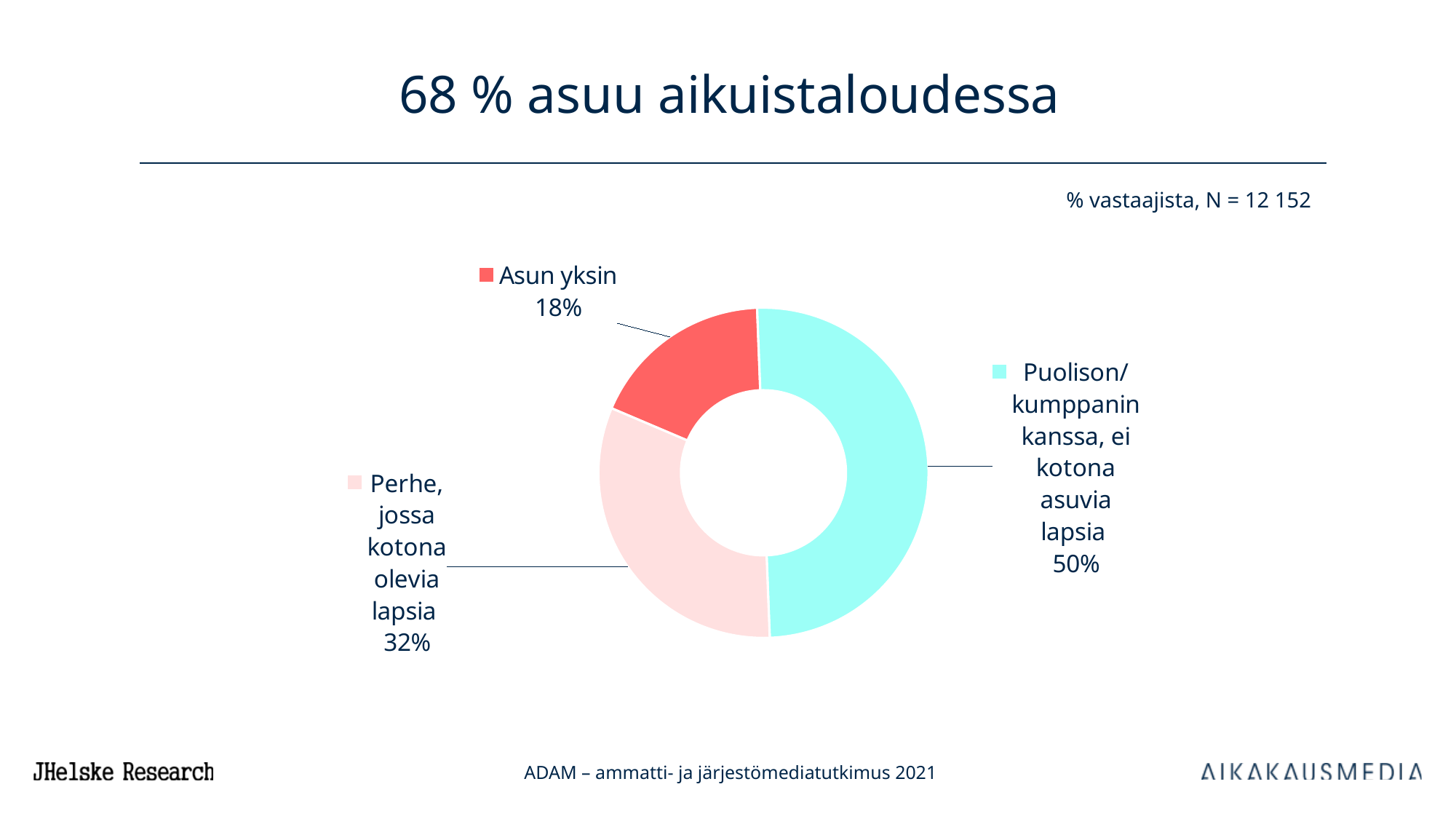
What is the sample size (N) stated on the slide? 12 152 What is the difference in percentage points between "Perhe, jossa kotona olevia lapsia" and "Asun yksin"? 14 What percentage of respondents answered "Puolison/kumppanin kanssa, ei kotona asuvia lapsia"? 50% What is the title of the slide? 68 % asuu aikuistaloudessa What percentage of respondents answered "Perhe, jossa kotona olevia lapsia"? 32% Which category has the smallest share of the chart? Asun yksin What kind of chart is shown on the slide? Pie chart (doughnut) Which category has the largest share of the chart? Puolison/kumppanin kanssa, ei kotona asuvia lapsia Which is larger: the share for "Asun yksin" or the share for "Perhe, jossa kotona olevia lapsia"? Perhe, jossa kotona olevia lapsia What is the difference in percentage points between "Puolison/kumppanin kanssa, ei kotona asuvia lapsia" and "Perhe, jossa kotona olevia lapsia"? 18 How many categories are shown in the chart? 3 What percentage of respondents answered "Asun yksin"? 18%